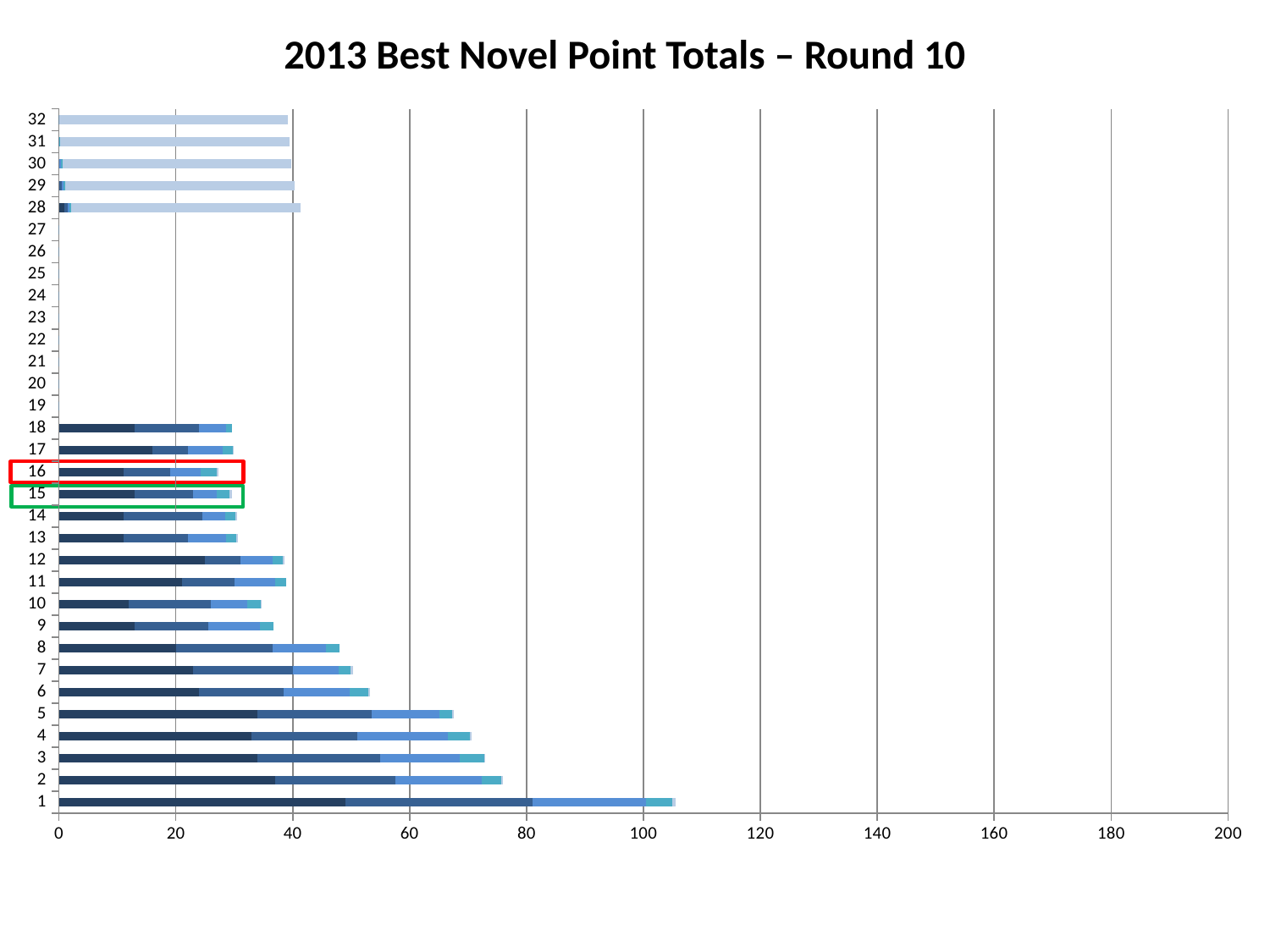
Is the total for category 3 greater or less than 60? greater Which category has the longest bar? 1 What is the title of the chart? 2013 Best Novel Point Totals – Round 10 What is the highest value shown on the horizontal axis? 200 Is the total for category 18 greater or less than 40? less Which category is outlined with a red box? 16 Is the total for category 2 greater or less than 80? less Which has the longer bar, category 6 or category 8? 6 How many categories are listed on the vertical axis? 32 Which has the longer bar, category 1 or category 2? 1 What kind of chart is shown on the slide? Stacked horizontal bar chart